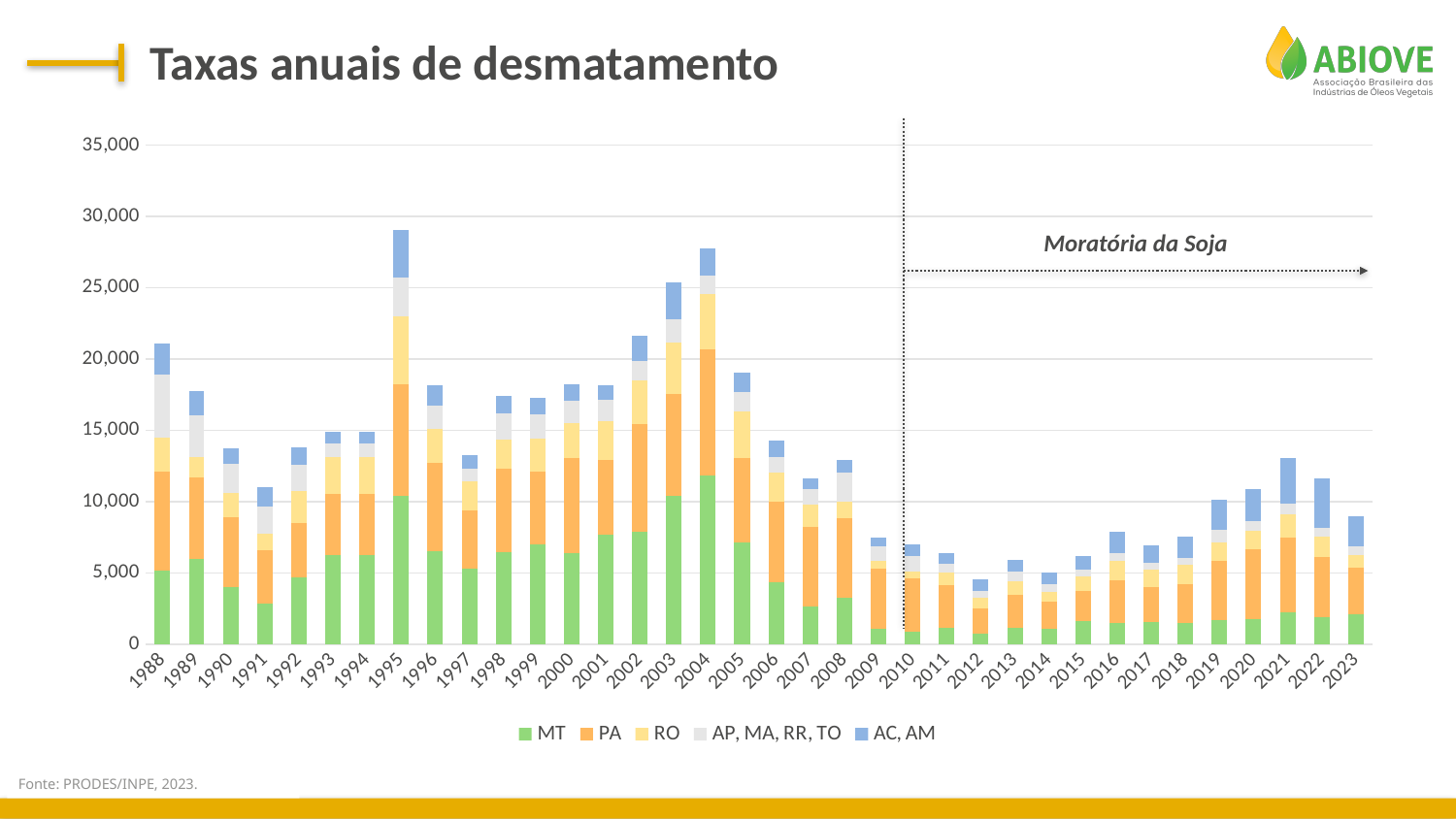
Which year has the larger total bar, 2004 or 2010? 2004 Is the total for 2010 greater or less than 10,000? less Is the total for 2021 greater or less than 10,000? greater What kind of chart is shown on the slide? Stacked bar chart What is the title of the chart? Taxas anuais de desmatamento Do the total bars rise or fall from 2004 to 2012? fall Is the total for 1995 greater or less than 25,000? greater Which year has the highest total bar? 1995 How many years are shown on the x axis? 36 How many series does the legend list? 5 What annotation is written above the dotted arrow on the right side of the chart? Moratória da Soja